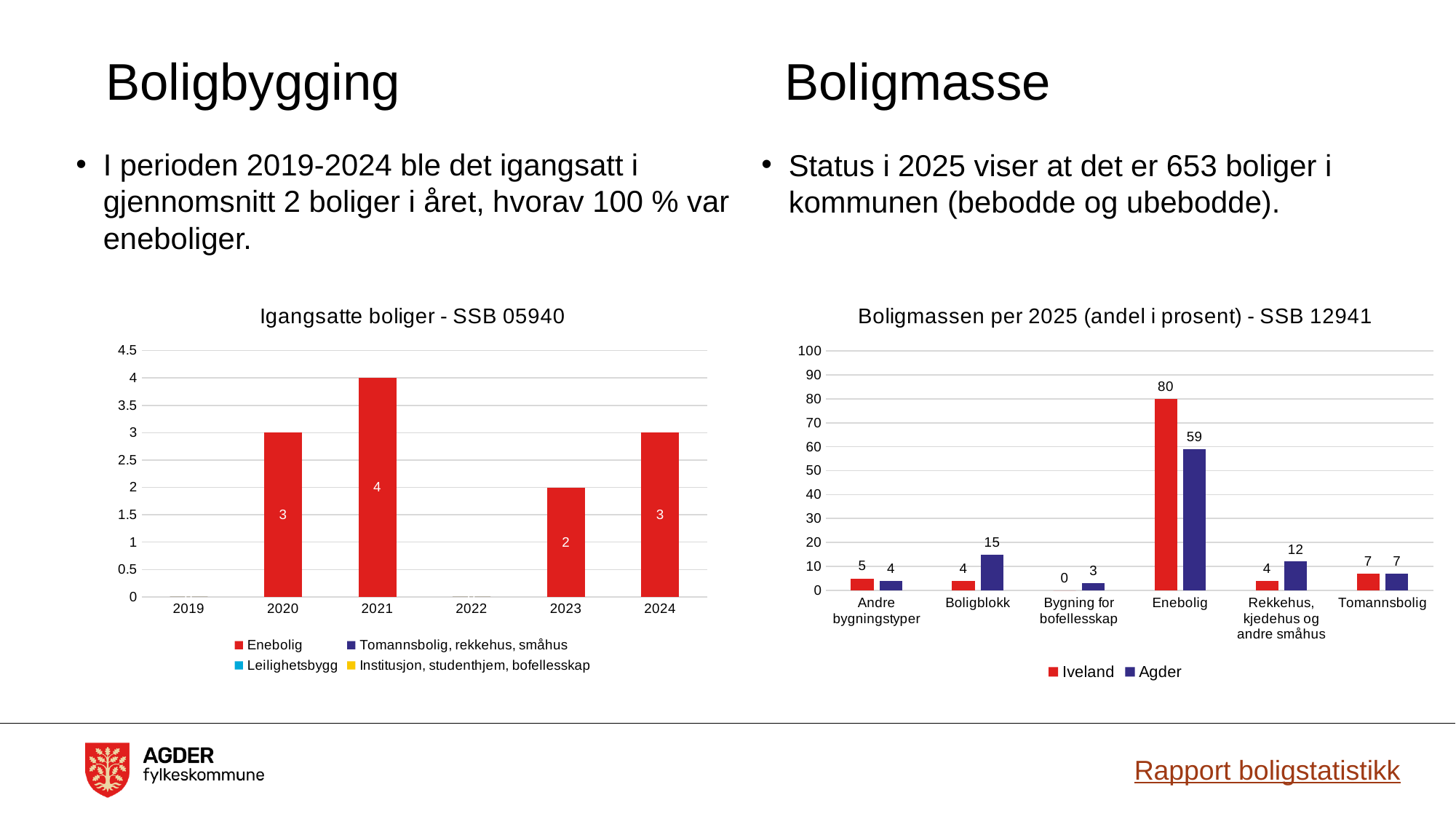
In the 'Boligmassen per 2025 (andel i prosent) - SSB 12941' chart, which is larger for Rekkehus, kjedehus og andre småhus: Iveland or Agder? Agder In the 'Igangsatte boliger - SSB 05940' chart, which year has the highest Enebolig value? 2021 In the 'Igangsatte boliger - SSB 05940' chart, what is the value for Enebolig in 2021? 4 In the 'Boligmassen per 2025 (andel i prosent) - SSB 12941' chart, what is the value for Agder for Boligblokk? 15 In the 'Igangsatte boliger - SSB 05940' chart, how many years are shown on the x axis? 6 In the 'Boligmassen per 2025 (andel i prosent) - SSB 12941' chart, how many categories are shown on the x axis? 6 In the 'Igangsatte boliger - SSB 05940' chart, what is the difference between the Enebolig values for 2021 and 2023? 2 In the 'Boligmassen per 2025 (andel i prosent) - SSB 12941' chart, what is the difference between Iveland and Agder for Enebolig? 21 What kind of chart is 'Boligmassen per 2025 (andel i prosent) - SSB 12941'? Bar chart In the 'Boligmassen per 2025 (andel i prosent) - SSB 12941' chart, which category has the highest Agder value? Enebolig In the 'Igangsatte boliger - SSB 05940' chart, how many series does the legend list? 4 In the 'Boligmassen per 2025 (andel i prosent) - SSB 12941' chart, what is the value for Iveland for Enebolig? 80